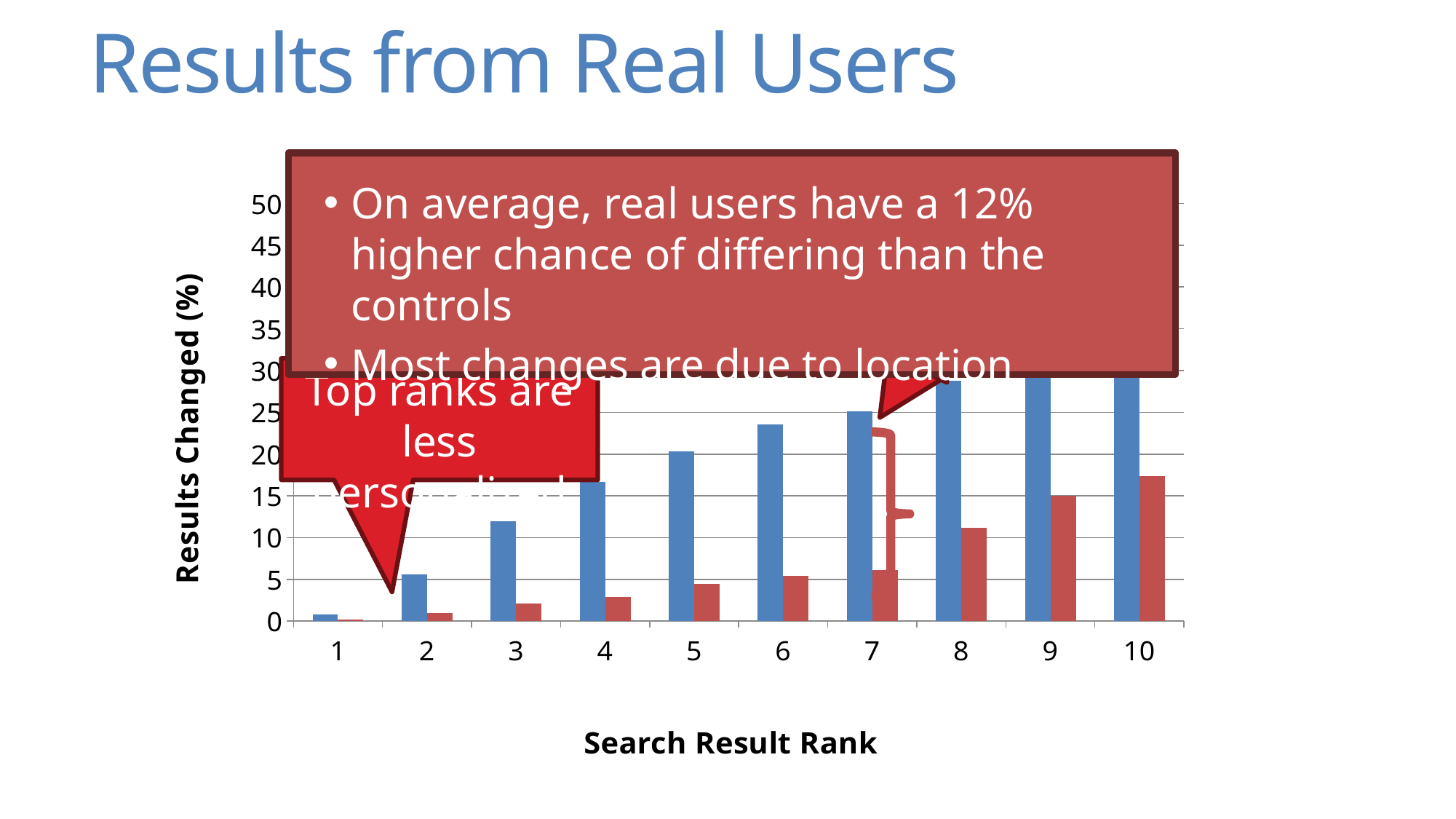
Is the blue bar for rank 2 greater or less than 10? less At rank 5, which bar is larger, the blue bar or the red bar? the blue bar Which is larger, the red bar for rank 9 or the red bar for rank 3? rank 9 Is the blue bar for rank 3 greater or less than 10? greater What is the title of the y axis of the chart? Results Changed (%) Is the red bar for rank 9 greater or less than 20? less Which search result rank has the highest red bar? 10 Do the red bars rise or fall as the search result rank increases from 1 to 10? rise How many search result ranks are shown on the x axis of the chart? 10 Which search result rank has the lowest blue bar? 1 What is the title of the x axis of the chart? Search Result Rank What kind of chart is shown on the slide? bar chart